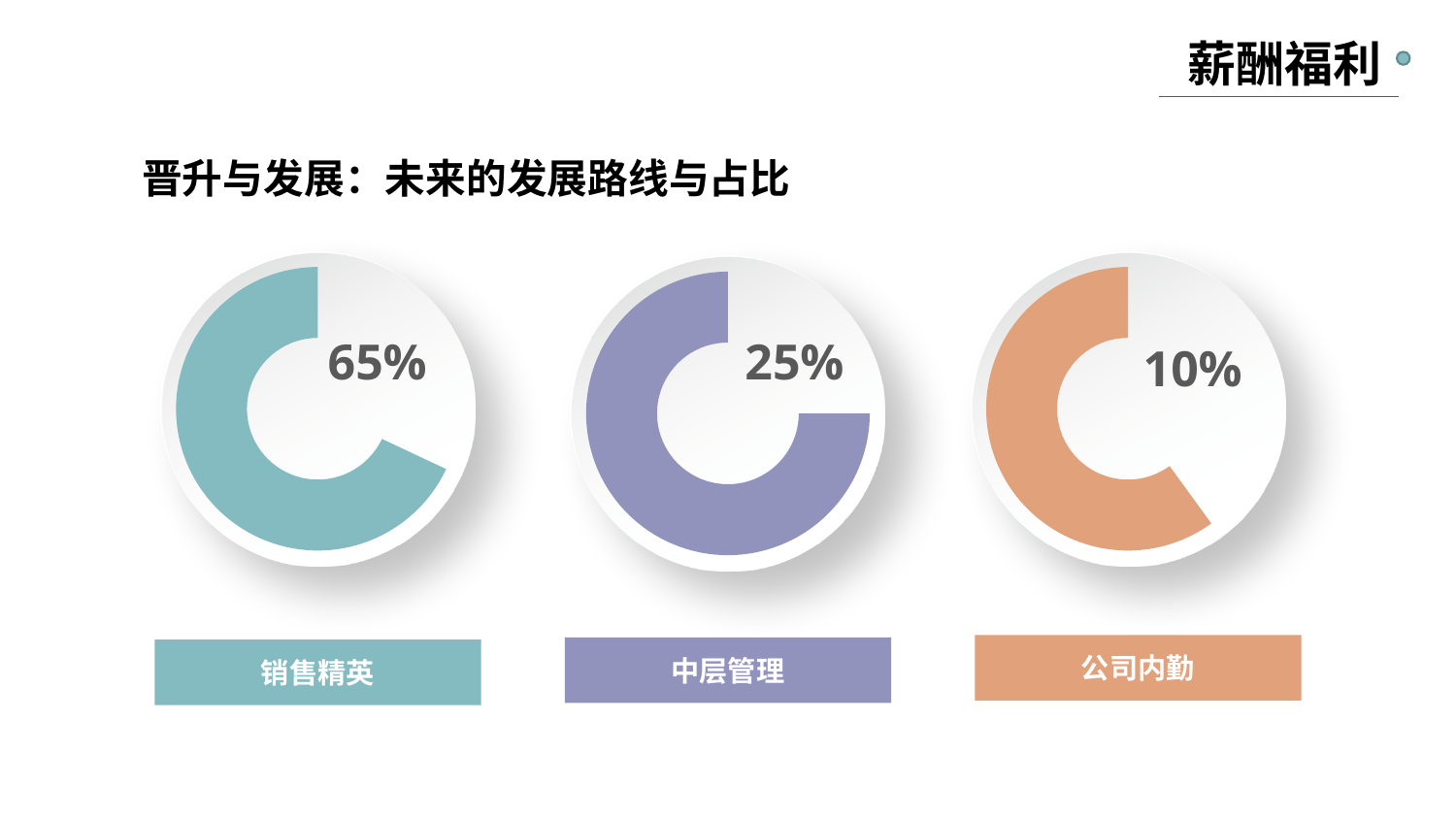
What is the difference between the percentage for 销售精英 and the percentage for 中层管理? 40% How many donut charts are shown on the slide? 3 What percentage is shown in the donut chart labelled 中层管理? 25% What is the difference between the percentage for 中层管理 and the percentage for 公司内勤? 15% Which is larger, the percentage for 中层管理 or the percentage for 公司内勤? 中层管理 What percentage is shown in the donut chart labelled 销售精英? 65% What percentage is shown in the donut chart labelled 公司内勤? 10% Which of the three donut charts shows the highest percentage? 销售精英 What kind of chart is used to show the percentage for 销售精英? Donut chart What colour is the donut chart for 公司内勤? Orange Which of the three donut charts shows the lowest percentage? 公司内勤 What is the total of the three percentages shown on the slide? 100%